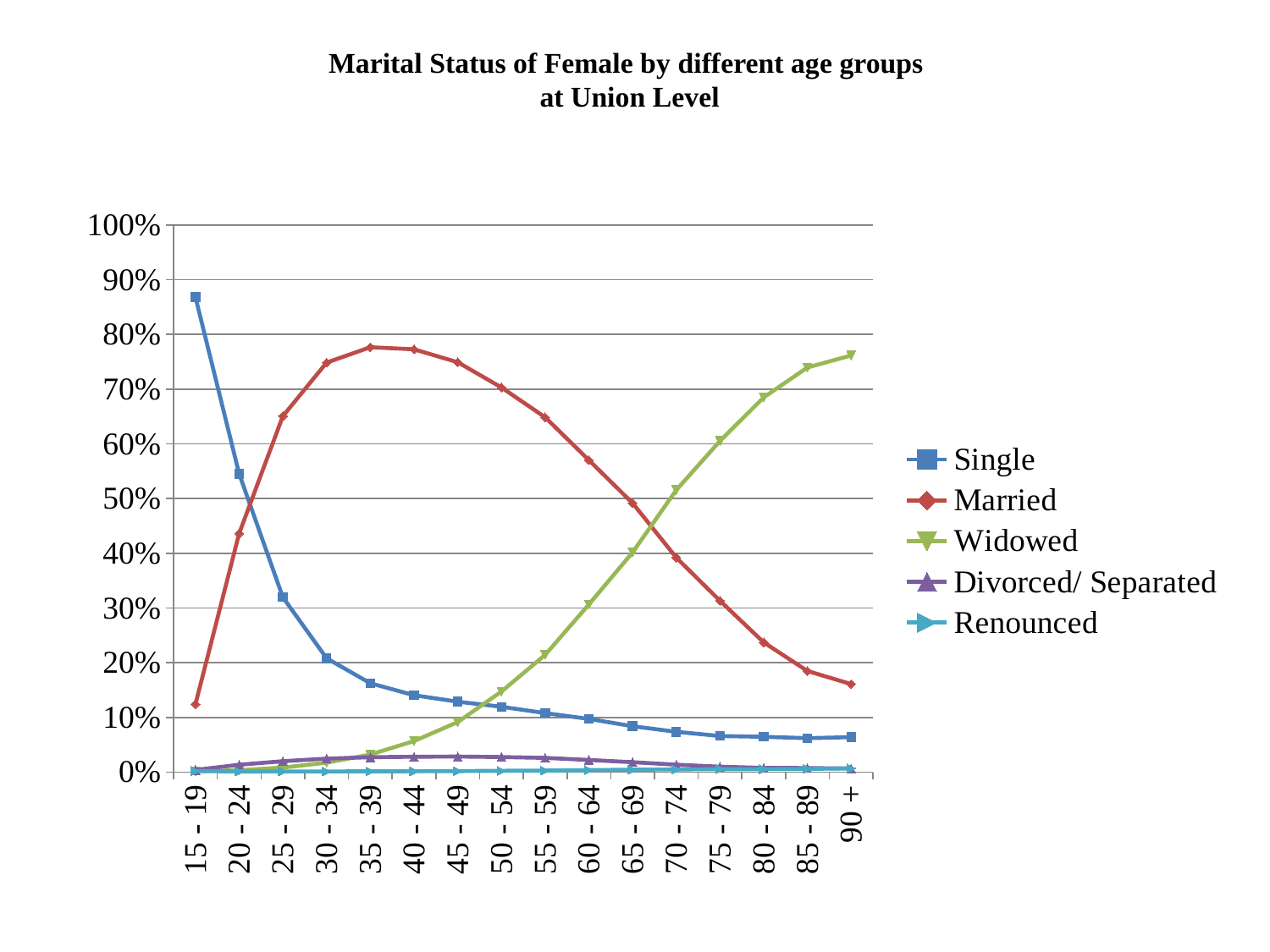
At 20 - 24, which is larger, Single or Married? Single What kind of chart is shown on the slide? line chart Does the Single series rise or fall as age increases along the x axis? fall Which age group has the lowest value for Married? 15 - 19 At 70 - 74, which is larger, Married or Widowed? Widowed Which age group has the highest value for Widowed? 90 + How many series does the legend list? 5 How many age groups are shown on the x axis? 16 Is the value for Single at 15 - 19 greater or less than 80%? greater Is the value for Married at 15 - 19 greater or less than 20%? less Which age group has the highest value for Single? 15 - 19 Is the value for Widowed at 90 + greater or less than 70%? greater